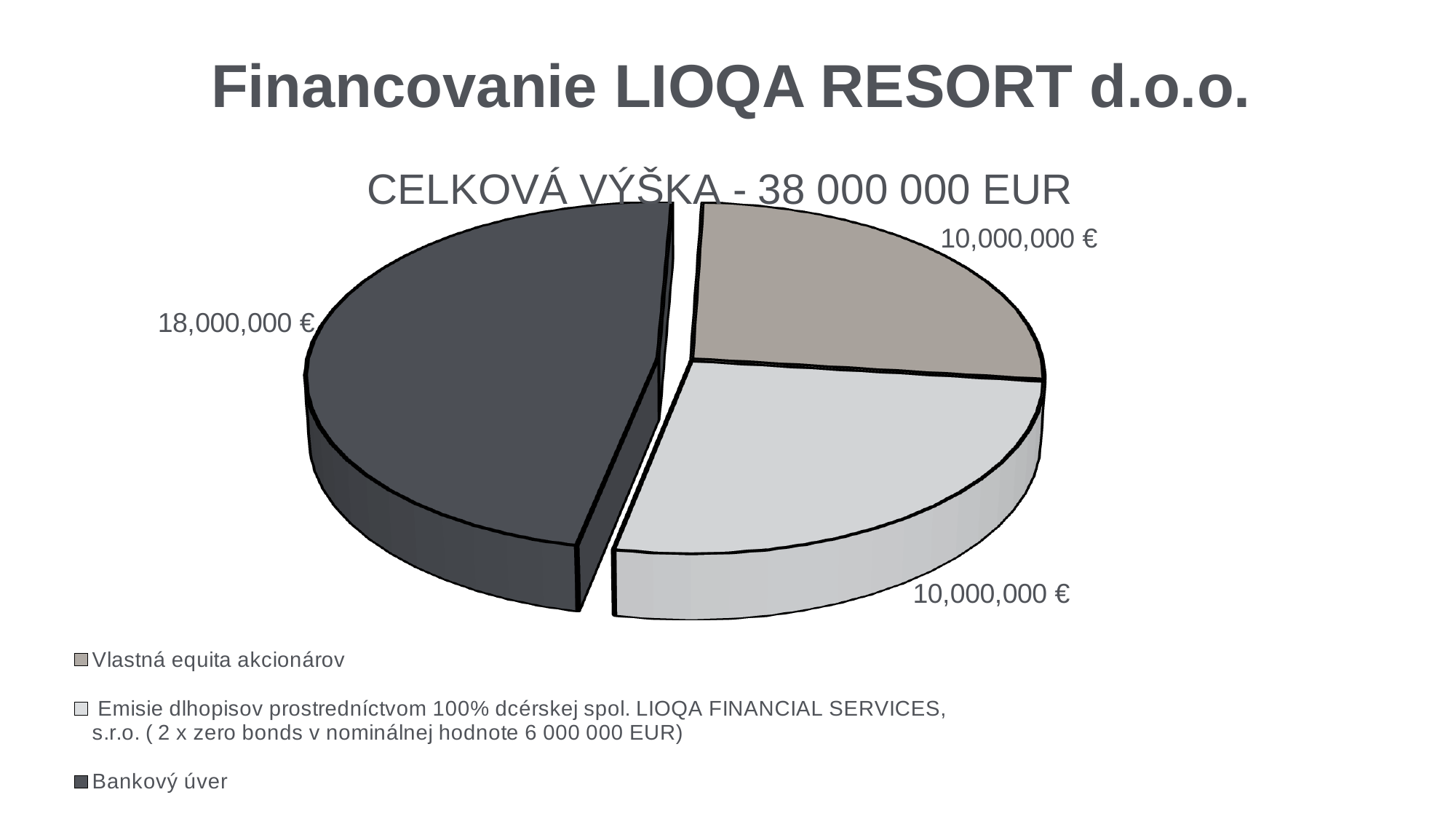
What is the value of the Vlastná equita akcionárov slice? 10,000,000 € What share of the 38 000 000 EUR total does the Bankový úver slice represent? 47.4% What kind of chart is shown on the slide? pie chart Which is larger, the Bankový úver slice or the Vlastná equita akcionárov slice? Bankový úver What is the difference between the Bankový úver value and the Vlastná equita akcionárov value? 8,000,000 € What is the value of the Bankový úver slice? 18,000,000 € What total amount does the chart title state? 38 000 000 EUR What is the value of the slice for Emisie dlhopisov prostredníctvom 100% dcérskej spol. LIOQA FINANCIAL SERVICES, s.r.o.? 10,000,000 € What is the title of the pie chart? CELKOVÁ VÝŠKA - 38 000 000 EUR Which category has the largest slice of the pie? Bankový úver How many slices does the pie chart have? 3 How many entries does the legend list? 3